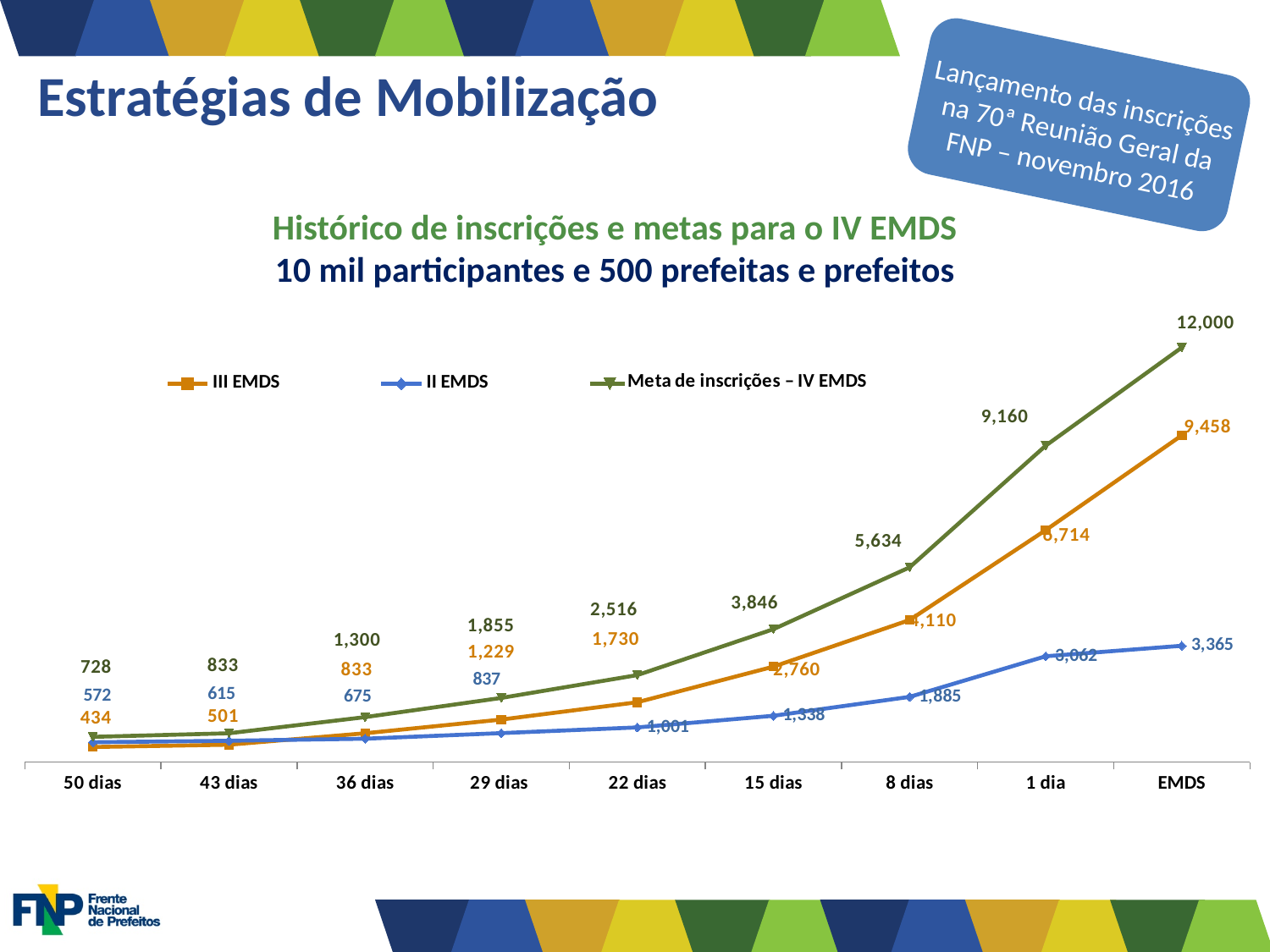
How many series does the chart legend list? 3 What is the difference between the Meta de inscrições – IV EMDS values at 1 dia and at 8 dias? 3,526 What is the value of the III EMDS series at EMDS? 9,458 What is the value of the Meta de inscrições – IV EMDS series at EMDS? 12,000 What is the value of the II EMDS series at EMDS? 3,365 What is the difference between the Meta de inscrições – IV EMDS value and the III EMDS value at EMDS? 2,542 At 50 dias, which is larger: the II EMDS value or the III EMDS value? II EMDS Which series has the highest value at EMDS? Meta de inscrições – IV EMDS How many categories are shown on the x axis of the chart? 9 What is the value of the Meta de inscrições – IV EMDS series at 8 dias? 5,634 What kind of chart is shown on the slide? line chart Does the Meta de inscrições – IV EMDS series rise or fall from 50 dias to EMDS? rise